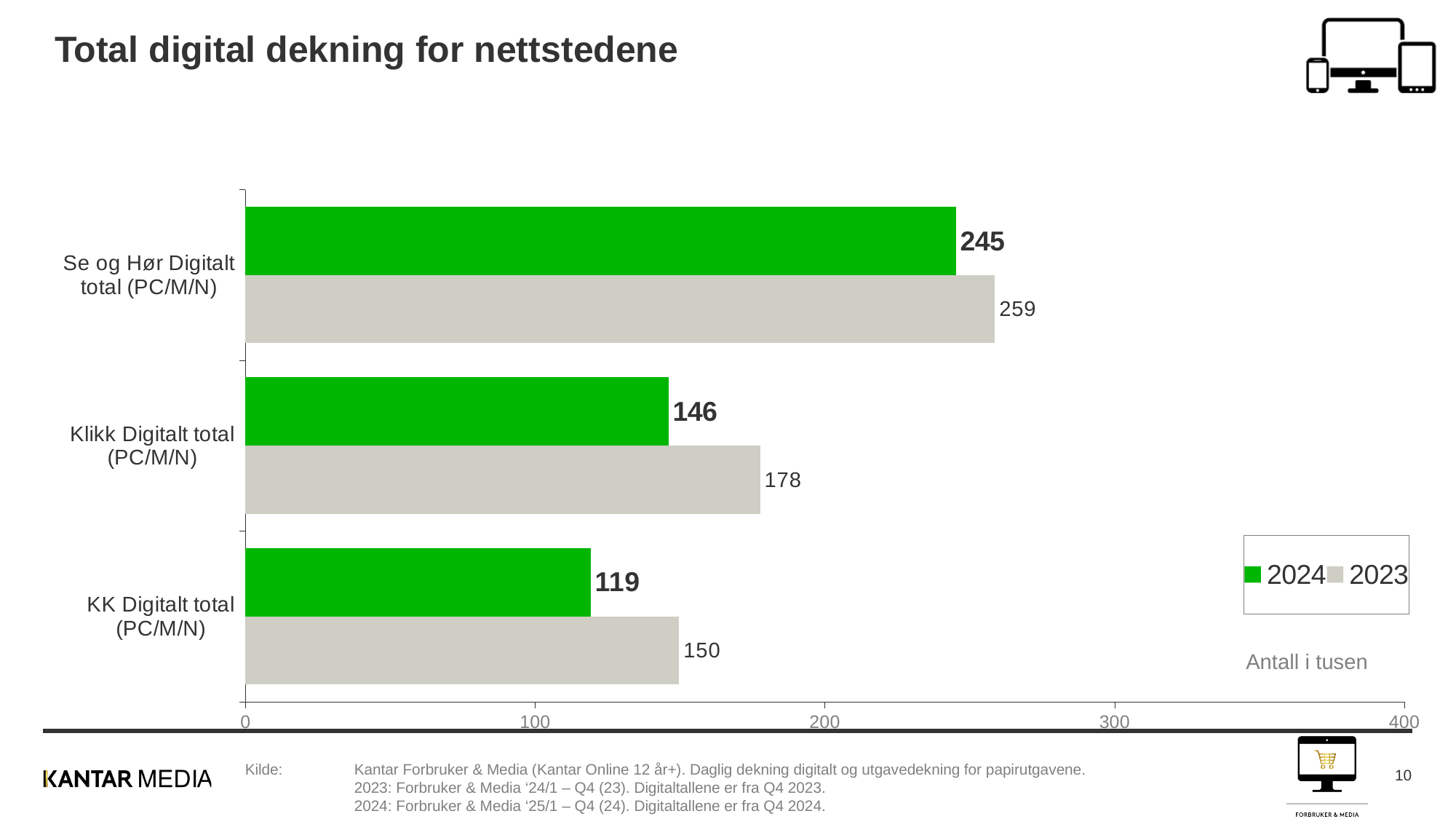
Which category has the highest 2024 value? Se og Hør Digitalt total (PC/M/N) Which category has the lowest 2023 value? KK Digitalt total (PC/M/N) How many categories are shown on the chart? 3 Which is larger for Se og Hør Digitalt total (PC/M/N): the 2024 value or the 2023 value? 2023 What is the 2023 value for KK Digitalt total (PC/M/N)? 150 What is the 2023 value for Klikk Digitalt total (PC/M/N)? 178 What is the 2024 value for KK Digitalt total (PC/M/N)? 119 What is the difference between the 2023 and 2024 values for Klikk Digitalt total (PC/M/N)? 32 What is the 2024 value for Se og Hør Digitalt total (PC/M/N)? 245 What kind of chart is shown on the slide? Bar chart How many series does the legend list? 2 What is the title of the chart? Total digital dekning for nettstedene